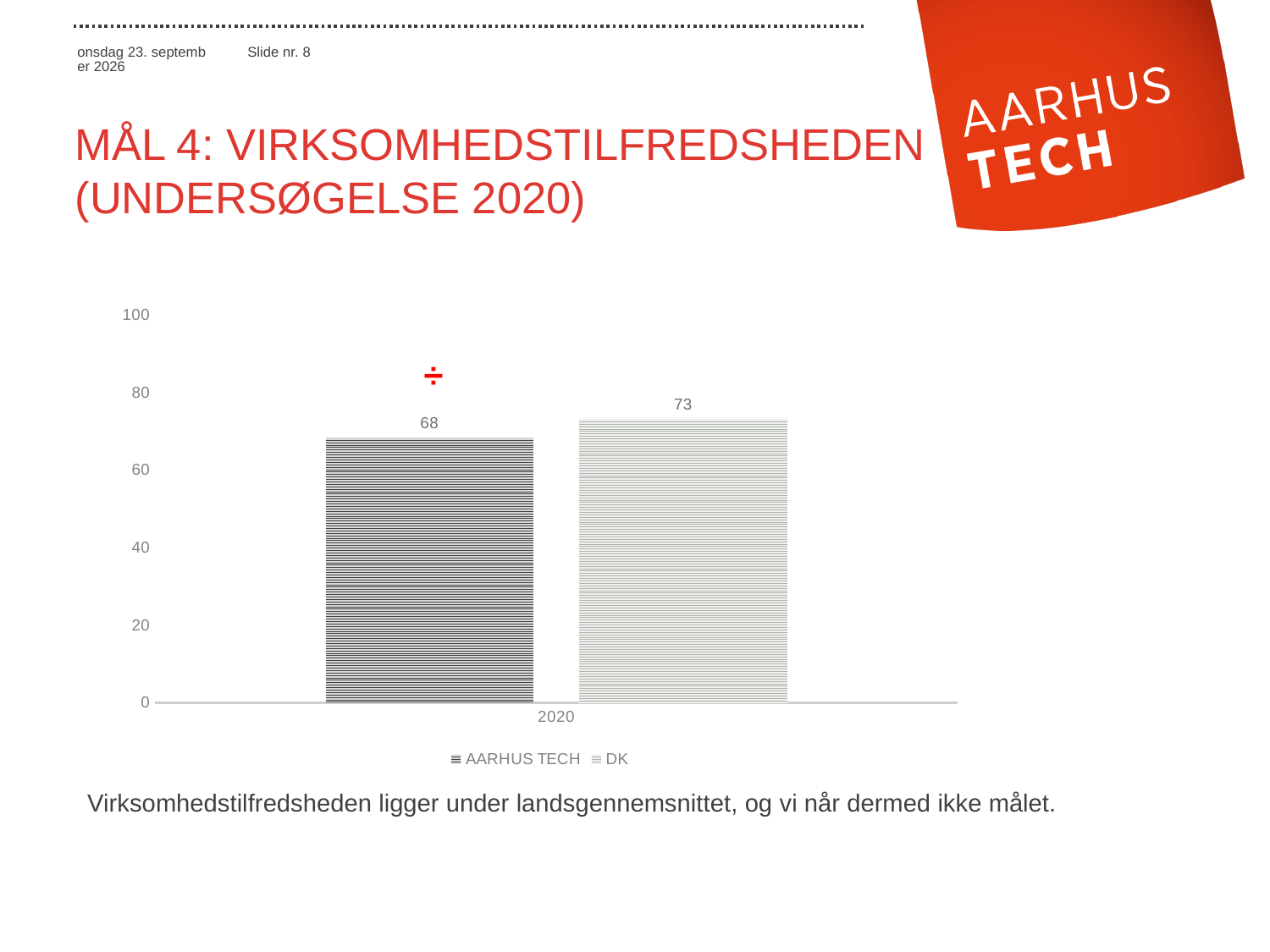
What kind of chart is shown on the slide? bar chart How many series does the legend list? 2 What is the difference between the DK value and the AARHUS TECH value in 2020? 5 Is the value for AARHUS TECH in 2020 greater or less than 80? less Is the value for DK in 2020 greater or less than 60? greater What is the value for AARHUS TECH in 2020? 68 How many categories are shown on the x axis? 1 What is the value for DK in 2020? 73 Which series has the lowest value in 2020? AARHUS TECH What are the two series listed in the legend? AARHUS TECH and DK Which series has the higher value in 2020, AARHUS TECH or DK? DK Which series has the highest value in 2020? DK